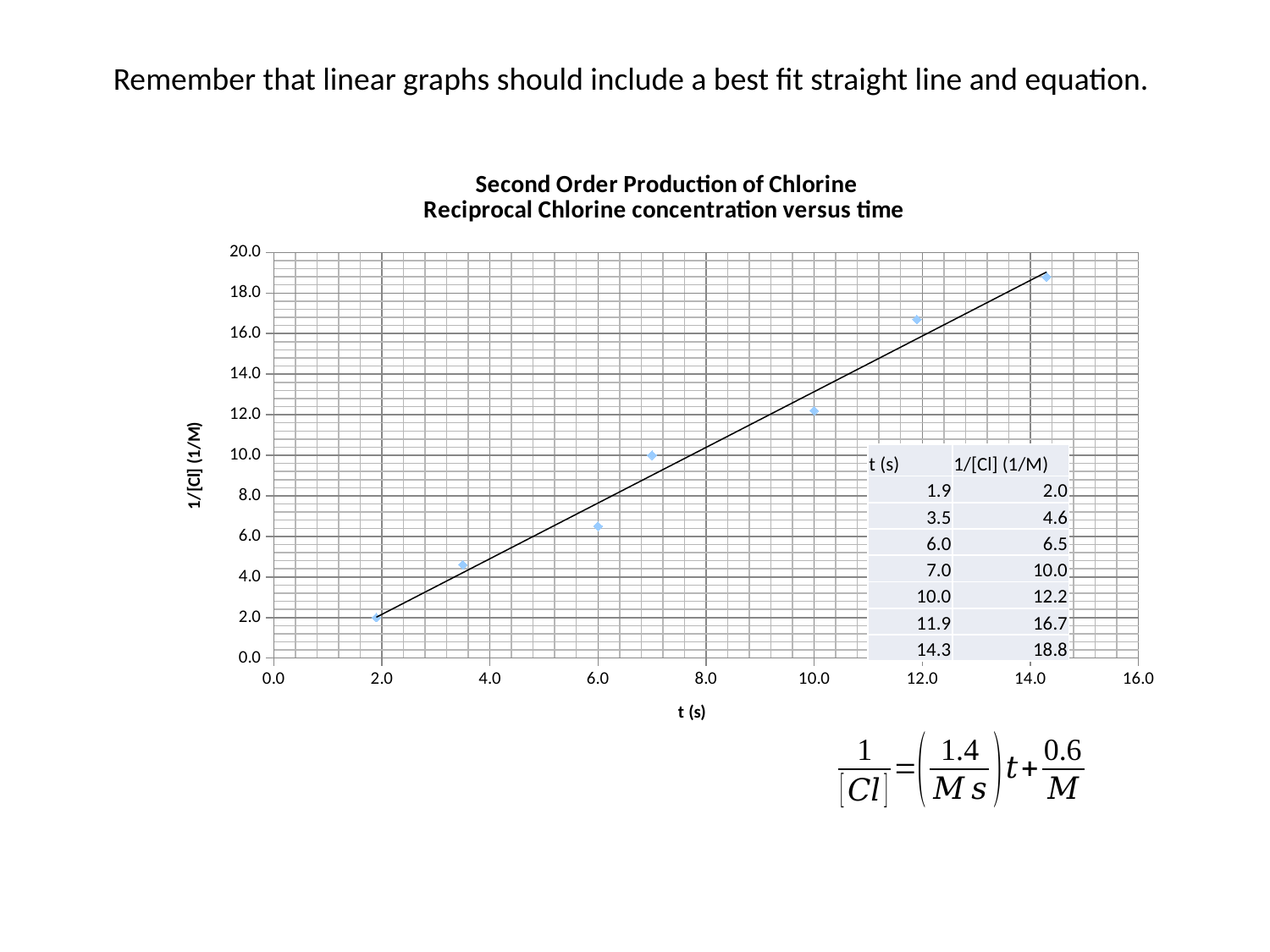
At which time t (s) is 1/[Cl] highest? 14.3 What is the label of the x axis? t (s) What is the value of 1/[Cl] at t = 11.9 s? 16.7 Is the 1/[Cl] value at t = 10.0 s greater or less than 14.0? less What is the difference between the 1/[Cl] values at t = 14.3 s and t = 1.9 s? 16.8 Do the 1/[Cl] values rise or fall as t increases? rise What is the title of the chart? Second Order Production of Chlorine Reciprocal Chlorine concentration versus time At which time t (s) is 1/[Cl] lowest? 1.9 How many data points are plotted on the chart? 7 What kind of chart is shown on the slide? scatter chart Which is larger, the 1/[Cl] value at t = 6.0 s or at t = 10.0 s? t = 10.0 s What is the value of 1/[Cl] at t = 7.0 s? 10.0